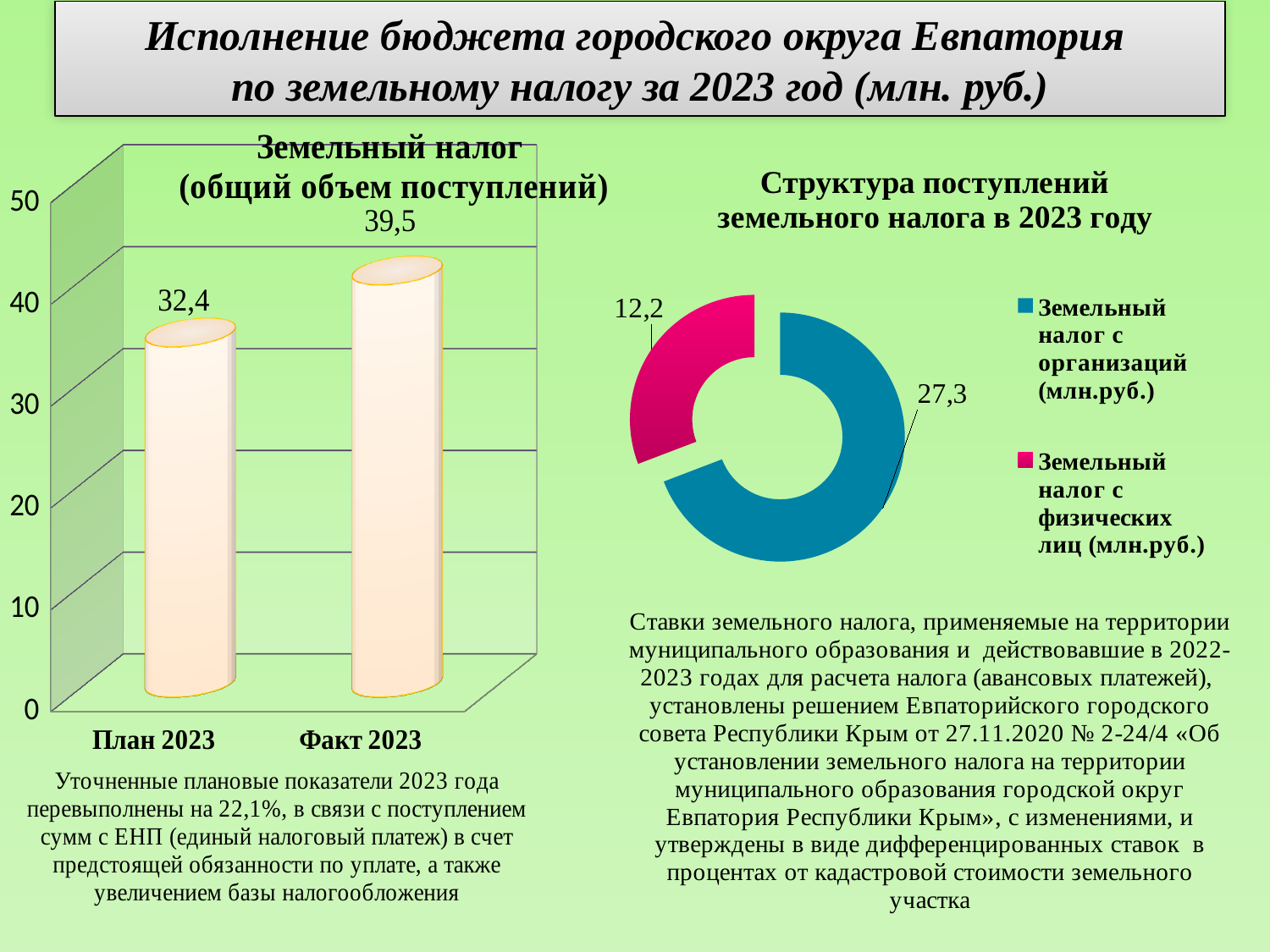
In the chart 'Структура поступлений земельного налога в 2023 году', which segment is larger: Земельный налог с организаций or Земельный налог с физических лиц? Земельный налог с организаций In the chart 'Земельный налог (общий объем поступлений)', what is the value for Факт 2023? 39,5 In the chart 'Структура поступлений земельного налога в 2023 году', what colour is the segment for Земельный налог с физических лиц? pink In the chart 'Структура поступлений земельного налога в 2023 году', what is the value for Земельный налог с физических лиц? 12,2 In the chart 'Земельный налог (общий объем поступлений)', is the value for План 2023 greater or less than 30? greater In the chart 'Земельный налог (общий объем поступлений)', what is the difference between Факт 2023 and План 2023? 7,1 In the chart 'Земельный налог (общий объем поступлений)', how many categories are shown? 2 What kind of chart is 'Земельный налог (общий объем поступлений)'? bar chart In the chart 'Структура поступлений земельного налога в 2023 году', what is the total of the two segments? 39,5 In the chart 'Структура поступлений земельного налога в 2023 году', what is the value for Земельный налог с организаций? 27,3 In the chart 'Земельный налог (общий объем поступлений)', which category has the higher value? Факт 2023 In the chart 'Земельный налог (общий объем поступлений)', what is the value for План 2023? 32,4